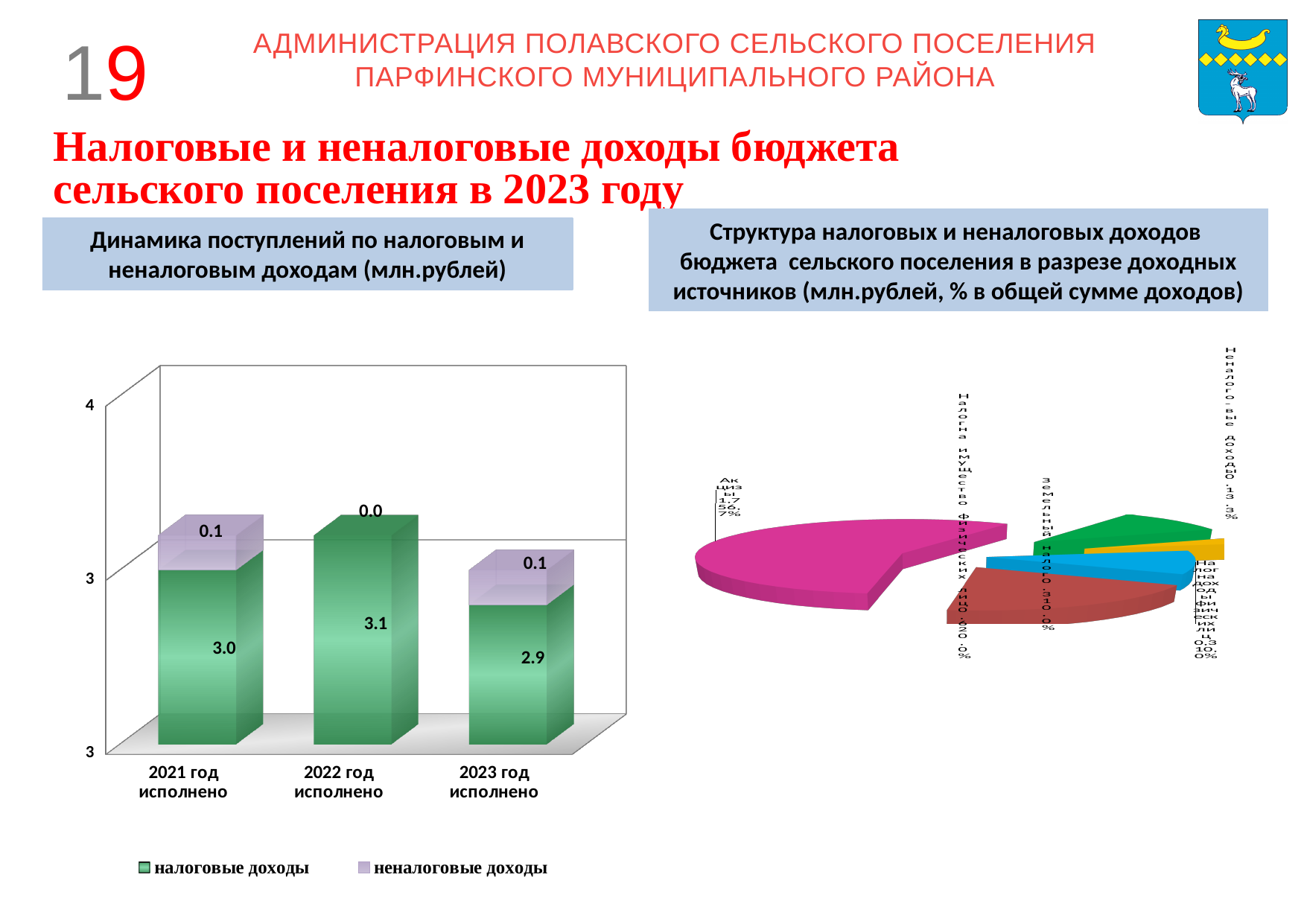
On the left chart (Динамика поступлений), what is the value of налоговые доходы for 2021 год исполнено? 3.0 What kind of chart is the left chart (Динамика поступлений)? Stacked bar chart On the left chart (Динамика поступлений), what is the value of неналоговые доходы for 2022 год исполнено? 0.0 What kind of chart is the right chart (Структура налоговых и неналоговых доходов)? Pie chart On the left chart (Динамика поступлений), what is the difference between налоговые доходы in 2022 and 2023? 0.2 On the left chart (Динамика поступлений), what is the total of the stacked bar for 2021 год исполнено? 3.1 On the left chart (Динамика поступлений), what is the value of неналоговые доходы for 2023 год исполнено? 0.1 On the left chart (Динамика поступлений), how many year categories are shown? 3 On the left chart (Динамика поступлений), in which year is налоговые доходы lowest? 2023 год исполнено On the left chart (Динамика поступлений), what is the value of налоговые доходы for 2022 год исполнено? 3.1 On the left chart (Динамика поступлений), how many series does the legend list? 2 On the left chart (Динамика поступлений), in which year is налоговые доходы highest? 2022 год исполнено